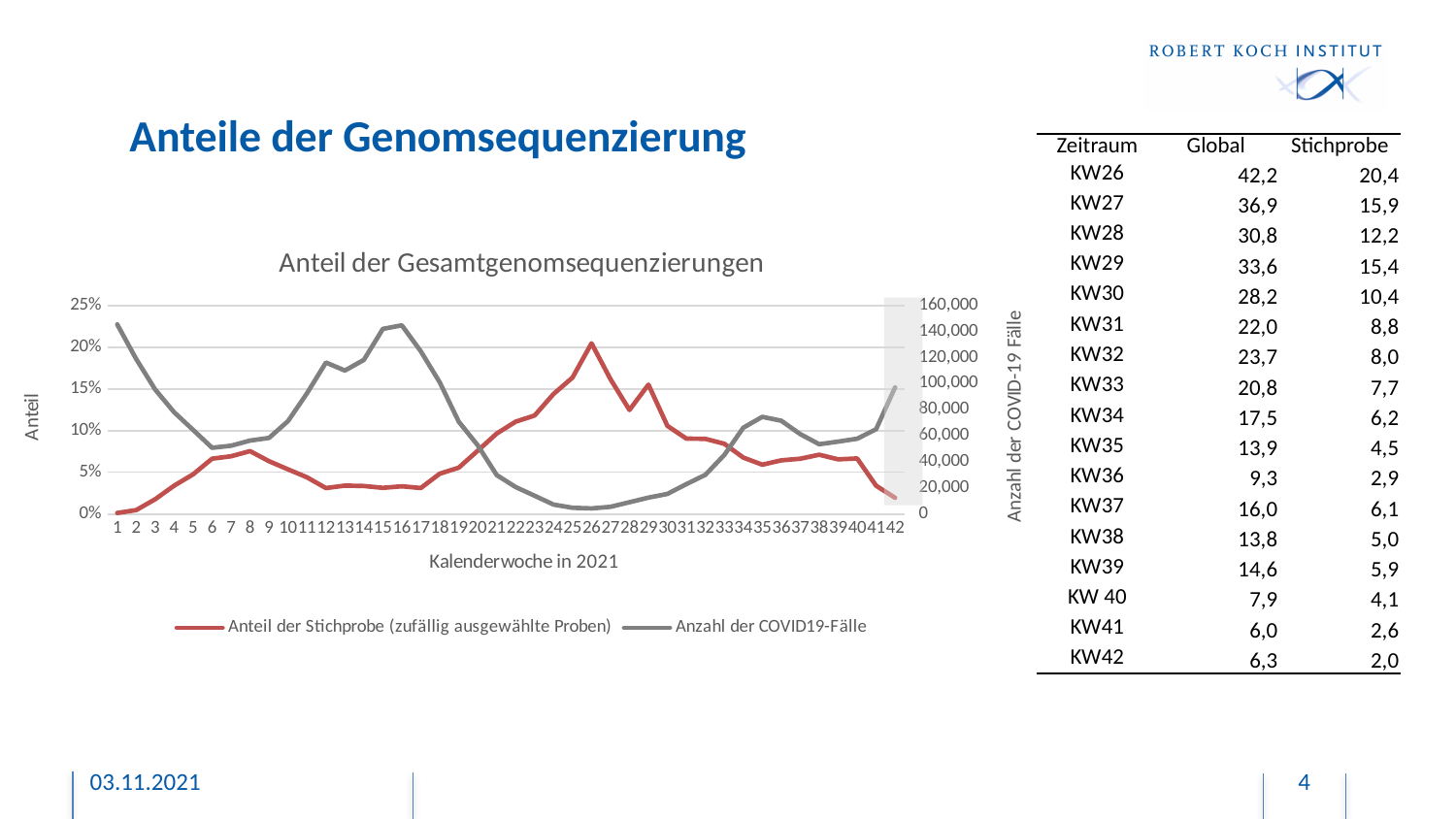
How many series does the chart legend list? 2 Is the value of 'Anzahl der COVID19-Fälle' in week 25 greater or less than 20,000? less In which calendar week does the series 'Anteil der Stichprobe (zufällig ausgewählte Proben)' reach its highest value? 26 Is the value of 'Anteil der Stichprobe (zufällig ausgewählte Proben)' in week 26 greater or less than 15%? greater Is the value of 'Anzahl der COVID19-Fälle' in week 1 greater or less than 120,000? greater Does the series 'Anzahl der COVID19-Fälle' rise or fall between week 16 and week 25? fall What is the title of the chart? Anteil der Gesamtgenomsequenzierungen What is the label of the x axis of the chart? Kalenderwoche in 2021 What kind of chart is shown on the slide? line chart Which is larger for 'Anteil der Stichprobe (zufällig ausgewählte Proben)': the value in week 8 or the value in week 26? week 26 How many calendar weeks are plotted along the x axis of the chart? 42